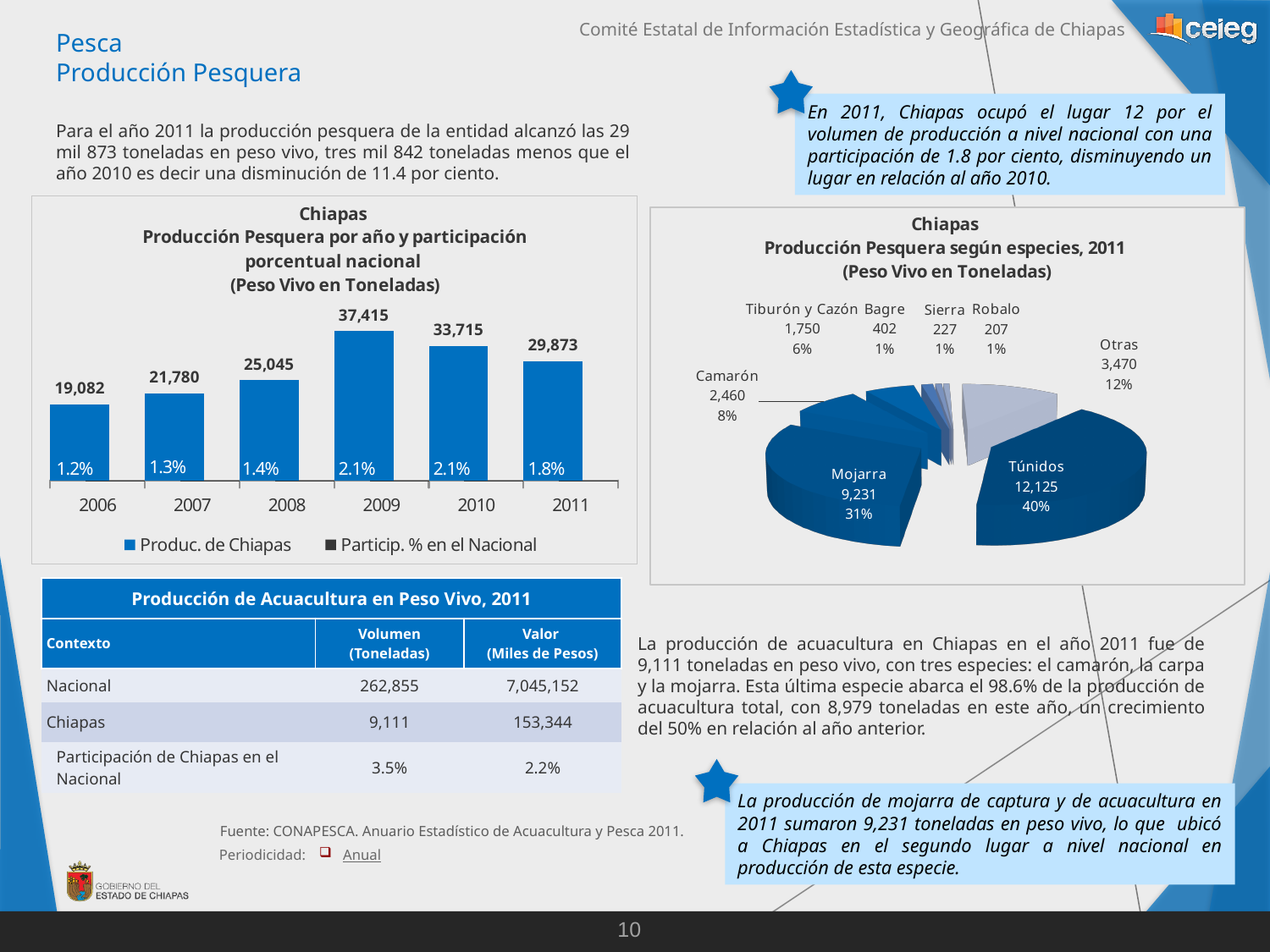
In the bar chart 'Producción Pesquera por año y participación porcentual nacional', which year has the highest production? 2009 In the pie chart 'Producción Pesquera según especies, 2011', which species has the largest share? Túnidos In the bar chart 'Producción Pesquera por año y participación porcentual nacional', did production rise or fall from 2009 to 2011? fall In the bar chart 'Producción Pesquera por año y participación porcentual nacional', how many series does the legend list? 2 In the pie chart 'Producción Pesquera según especies, 2011', what is the production of Mojarra in tonnes? 9,231 What kind of chart is 'Producción Pesquera según especies, 2011'? pie chart In the bar chart 'Producción Pesquera por año y participación porcentual nacional', what was the production of Chiapas in 2009? 37,415 In the bar chart 'Producción Pesquera por año y participación porcentual nacional', how many years are shown on the x axis? 6 In the bar chart 'Producción Pesquera por año y participación porcentual nacional', what was the national participation percentage for 2011? 1.8% In the bar chart 'Producción Pesquera por año y participación porcentual nacional', which year has the lowest production? 2006 In the pie chart 'Producción Pesquera según especies, 2011', what share of production does Camarón represent? 8% In the bar chart 'Producción Pesquera por año y participación porcentual nacional', what is the difference between the production in 2010 and in 2011? 3,842